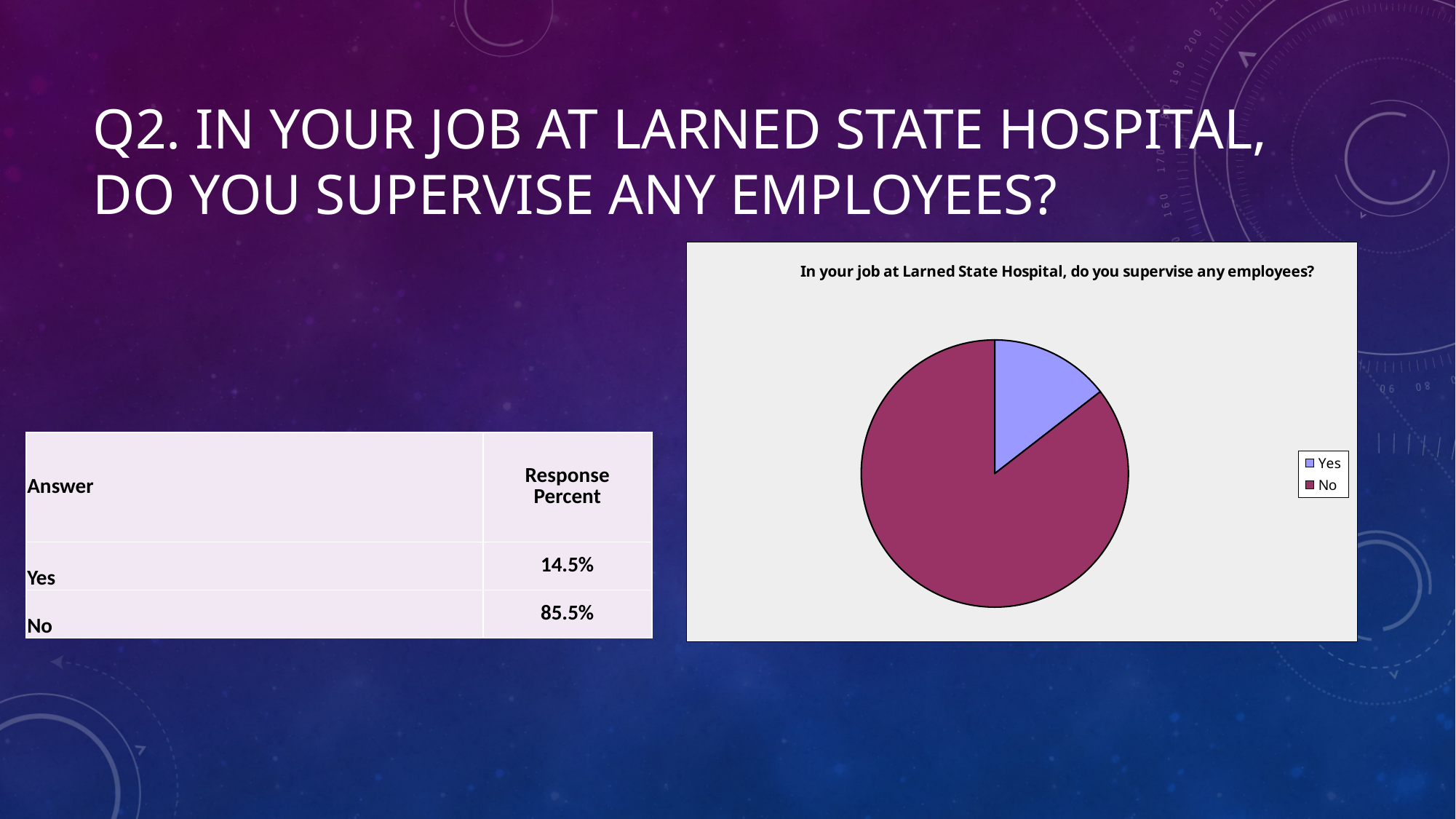
What is the difference between the response percents for No and Yes shown in the table? 71.0% What share of the pie does the No slice represent, according to the table? 85.5% According to the table on the slide, what is the response percent for Yes? 14.5% Which response has the smallest slice in the pie chart? Yes How many slices does the pie chart have? 2 What kind of chart is shown on the slide? pie chart What colour is the Yes slice in the pie chart? light blue/purple What is the title of the pie chart? In your job at Larned State Hospital, do you supervise any employees? According to the table on the slide, what is the response percent for No? 85.5% Which response has the largest slice in the pie chart? No Is the slice for No larger or smaller than the slice for Yes? larger How many entries does the pie chart's legend list? 2